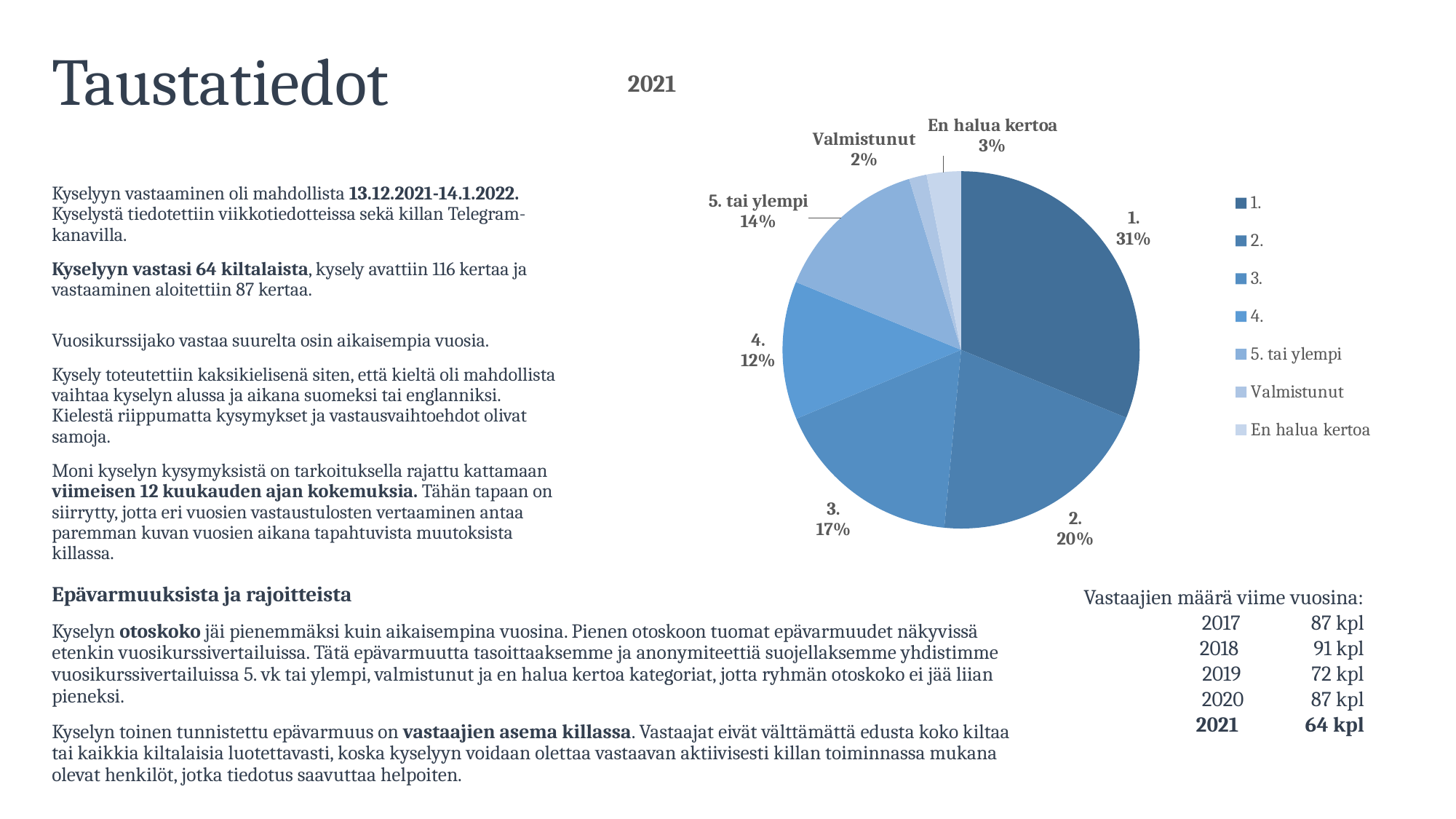
What is the title of the pie chart? 2021 Which category has the smallest share of the pie? Valmistunut What type of chart is shown on the slide? pie chart Which category has the largest share of the pie? 1. What share of the pie does the category "1." have? 31% What share of the pie does "Valmistunut" have? 2% What is the difference in percentage points between the shares of "1." and "2."? 11 Which has a larger share, "4." or "5. tai ylempi"? 5. tai ylempi How many categories does the pie chart have? 7 How many entries does the legend list? 7 What share of the pie does the category "3." have? 17% What share of the pie does "5. tai ylempi" have? 14%